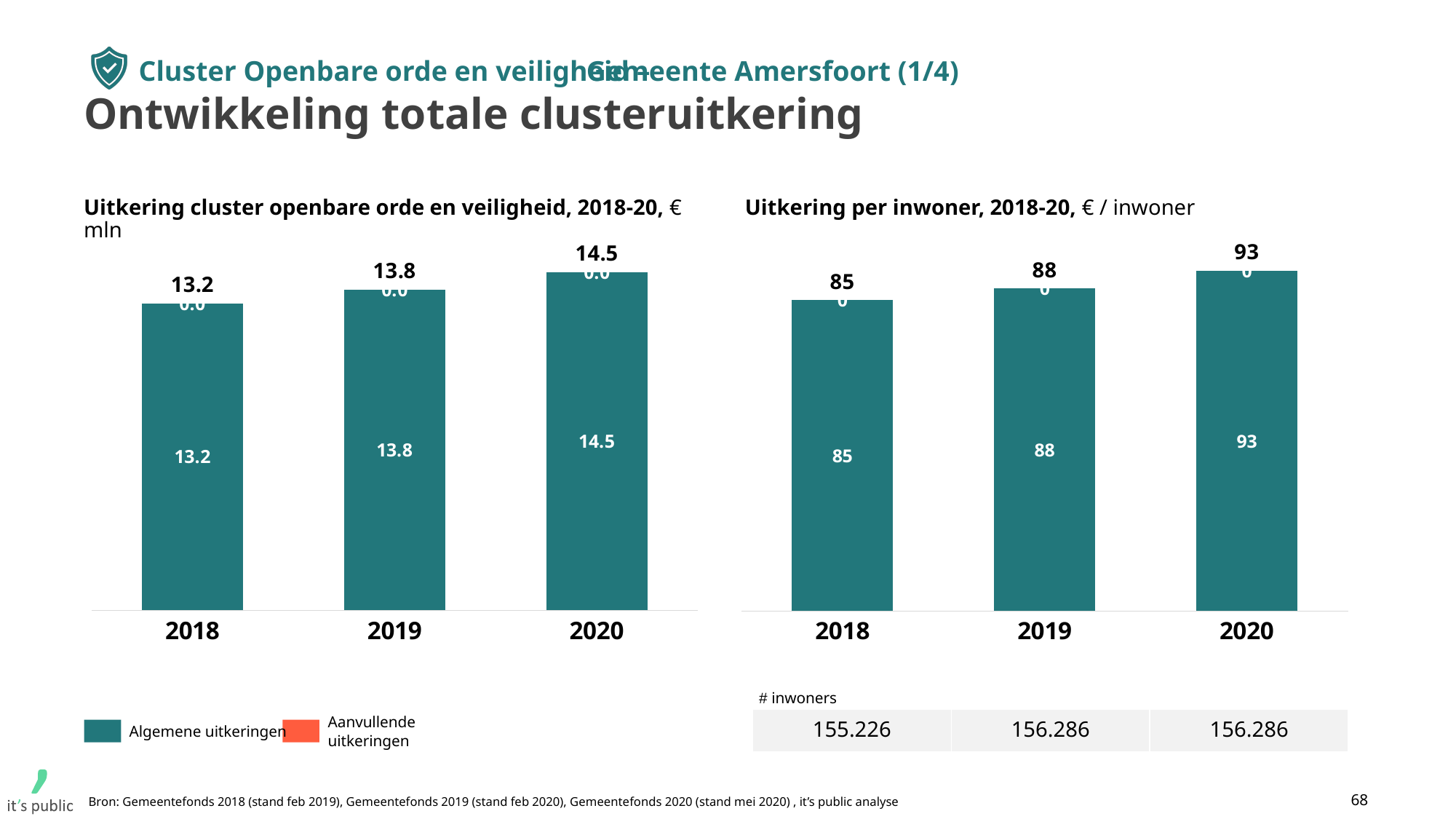
In the left chart (Uitkering cluster openbare orde en veiligheid), what is the total value for 2020? 14.5 In the right chart (Uitkering per inwoner), which year has the highest value? 2020 What kind of chart is the right chart (Uitkering per inwoner)? bar chart In the right chart (Uitkering per inwoner), what is the difference between the 2020 and 2018 values? 8 In the left chart (Uitkering cluster openbare orde en veiligheid), do the totals rise or fall from 2018 to 2020? rise In the left chart (Uitkering cluster openbare orde en veiligheid), what is the total value for 2018? 13.2 How many years are shown on the x axis of the left chart (Uitkering cluster openbare orde en veiligheid)? 3 In the left chart (Uitkering cluster openbare orde en veiligheid), which year has the lowest total? 2018 In the left chart (Uitkering cluster openbare orde en veiligheid), what is the difference between the 2020 and 2018 totals? 1.3 In the right chart (Uitkering per inwoner), what is the value for 2019? 88 In the right chart (Uitkering per inwoner), is the value for 2019 larger or smaller than the value for 2018? larger How many series does the legend below the left chart list? 2